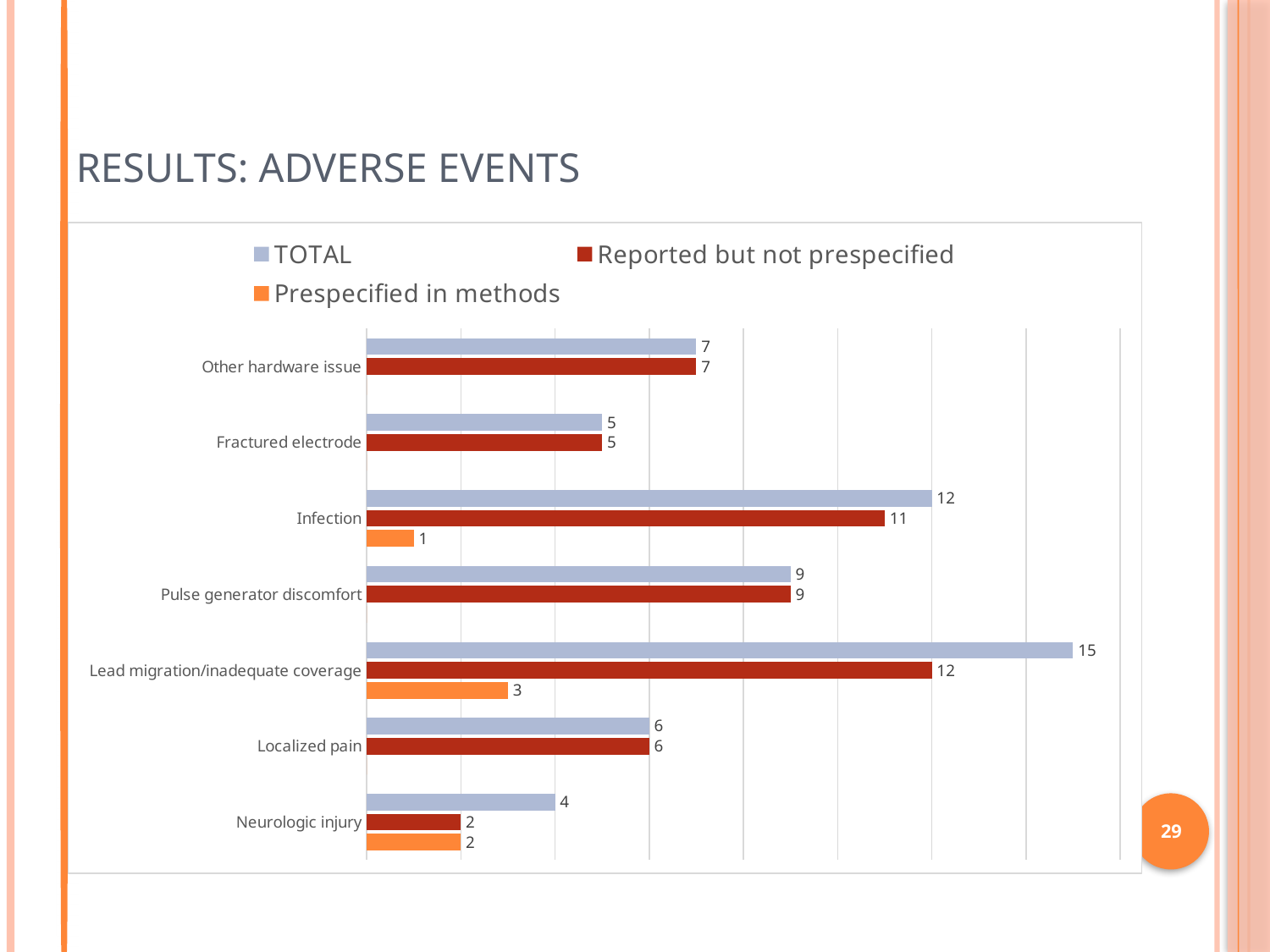
What is the TOTAL value for Infection? 12 How many series does the legend list? 3 What is the title of the slide containing the chart? RESULTS: ADVERSE EVENTS Which category has the highest TOTAL value? Lead migration/inadequate coverage Which category has the lowest TOTAL value? Neurologic injury Which is larger: the TOTAL for Infection or the TOTAL for Pulse generator discomfort? Infection What kind of chart is shown on the slide? Bar chart What is the 'Prespecified in methods' value for Neurologic injury? 2 What is the 'Reported but not prespecified' value for Infection? 11 What is the difference between the TOTAL and the 'Reported but not prespecified' values for Lead migration/inadequate coverage? 3 What is the 'Reported but not prespecified' value for Lead migration/inadequate coverage? 12 How many categories are shown on the y axis? 7